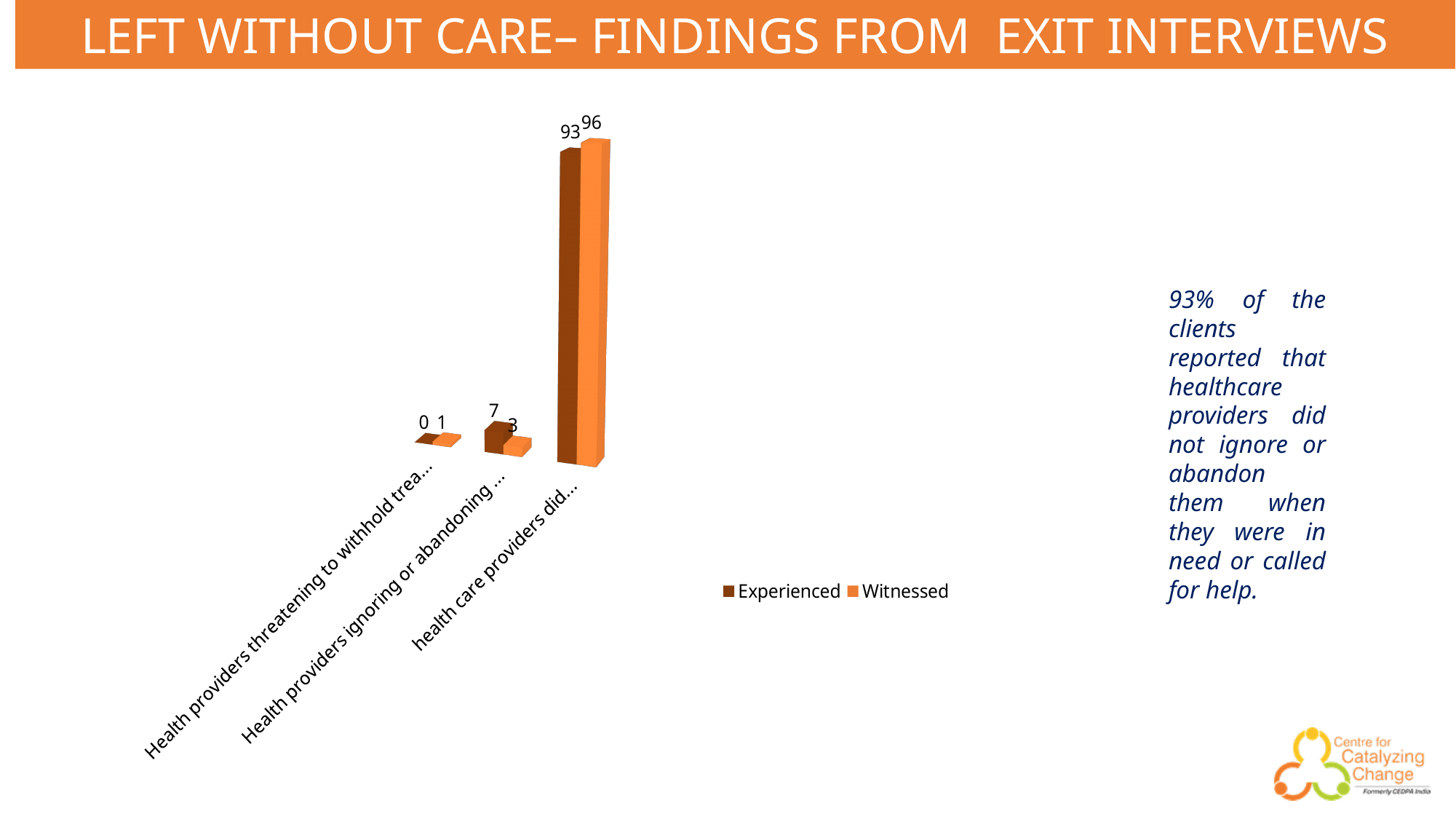
How many categories are plotted on the chart? 3 Which category has the highest Witnessed value? health care providers did... What is the Witnessed value for the category beginning "Health providers threatening to withhold trea..."? 1 What are the two series named in the chart legend? Experienced and Witnessed What kind of chart is shown on the slide? bar chart How many series does the chart legend list? 2 What is the Experienced value for the category beginning "Health providers ignoring or abandoning..."? 7 For the category beginning "Health providers ignoring or abandoning...", which is larger, the Experienced value or the Witnessed value? Experienced What is the Experienced value for the category beginning "health care providers did..."? 93 Which category has the lowest Experienced value? Health providers threatening to withhold trea... What is the difference between the Witnessed and Experienced values for the category beginning "health care providers did..."? 3 What is the Witnessed value for the category beginning "health care providers did..."? 96